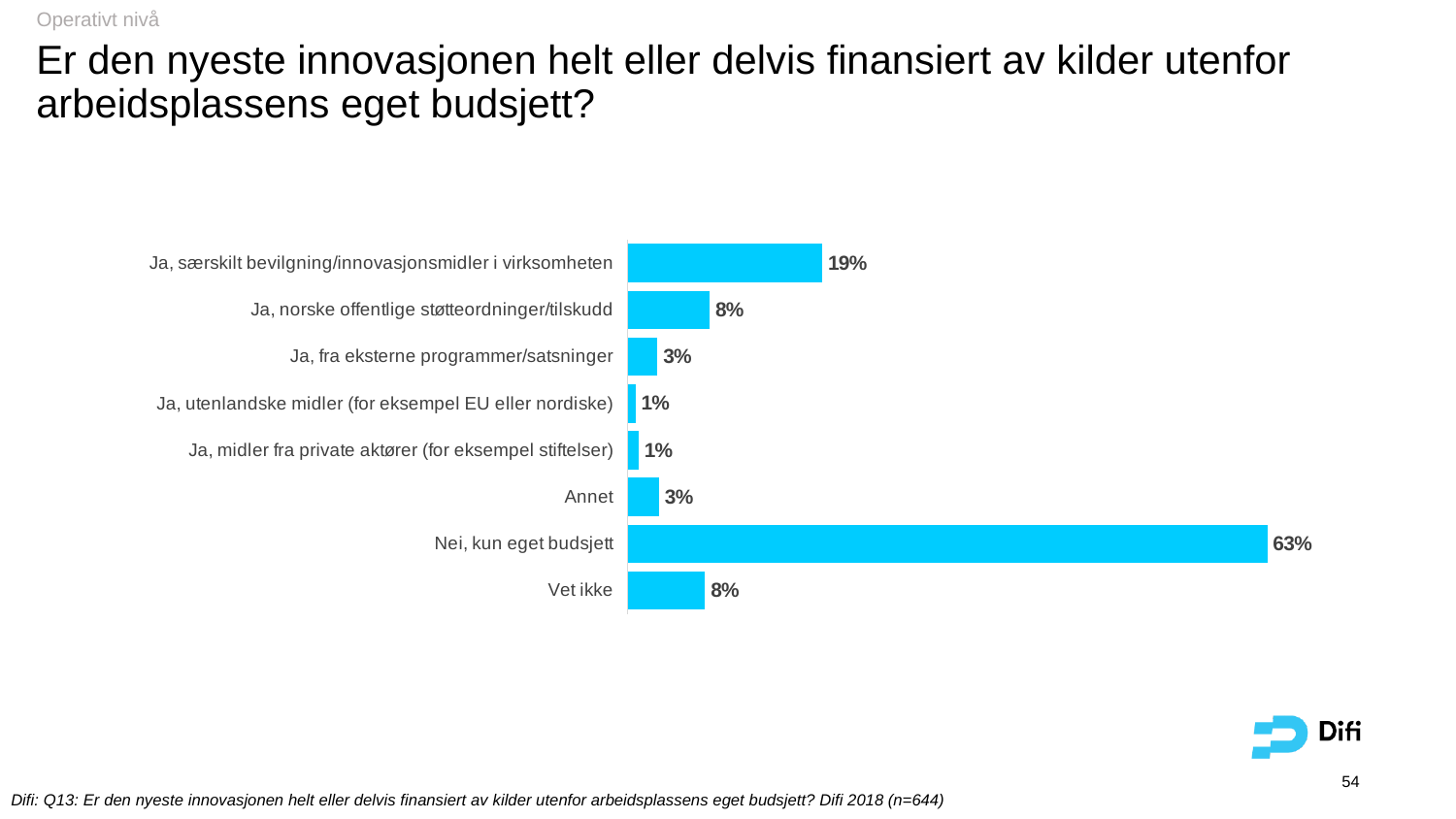
How many categories are shown in the chart? 8 Which is larger: "Ja, norske offentlige støtteordninger/tilskudd" or "Annet"? Ja, norske offentlige støtteordninger/tilskudd Which category has the highest value? Nei, kun eget budsjett What is the value for "Nei, kun eget budsjett"? 63% What colour are the bars in the chart? Light blue What is the value for "Ja, særskilt bevilgning/innovasjonsmidler i virksomheten"? 19% What is the value for "Ja, fra eksterne programmer/satsninger"? 3% What kind of chart is shown on the slide? Bar chart What is the value for "Vet ikke"? 8% What is the difference between "Nei, kun eget budsjett" and "Ja, særskilt bevilgning/innovasjonsmidler i virksomheten"? 44% What is the value for "Ja, utenlandske midler (for eksempel EU eller nordiske)"? 1% What is the difference between "Ja, norske offentlige støtteordninger/tilskudd" and "Ja, fra eksterne programmer/satsninger"? 5%